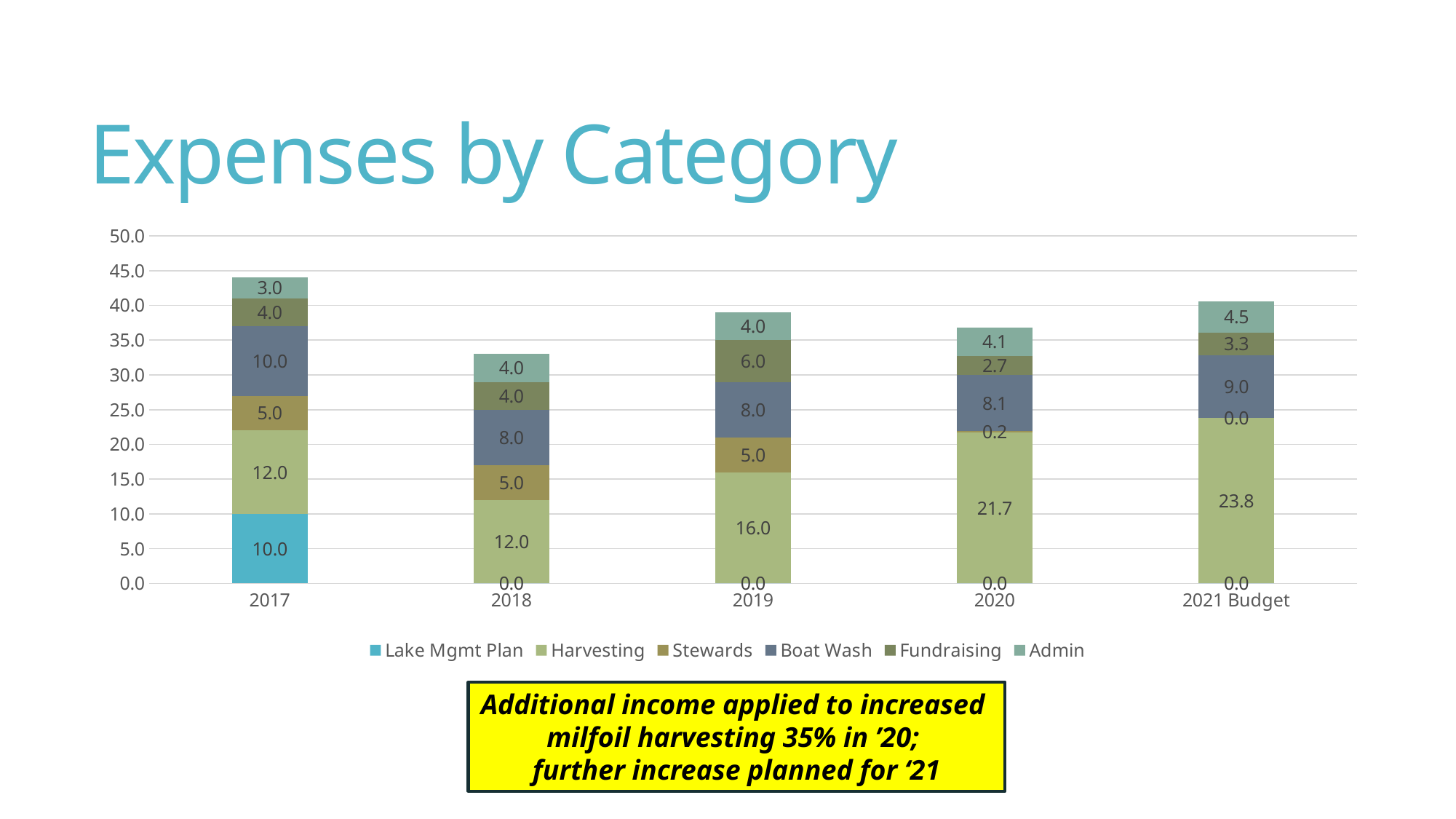
How many series does the legend list? 6 What is the Harvesting value for 2020? 21.7 What is the Lake Mgmt Plan value for 2017? 10.0 What is the difference between the Harvesting values for 2019 and 2018? 4.0 How many categories are shown on the x axis? 5 What is the Stewards value for 2020? 0.2 Which category has the lowest Fundraising value? 2020 What is the total of the stacked bar for 2017? 44.0 What is the Boat Wash value for 2021 Budget? 9.0 Is the Admin value for 2021 Budget larger or smaller than the Admin value for 2017? Larger What type of chart is shown on the slide? Stacked bar chart Which category has the highest Harvesting value? 2021 Budget